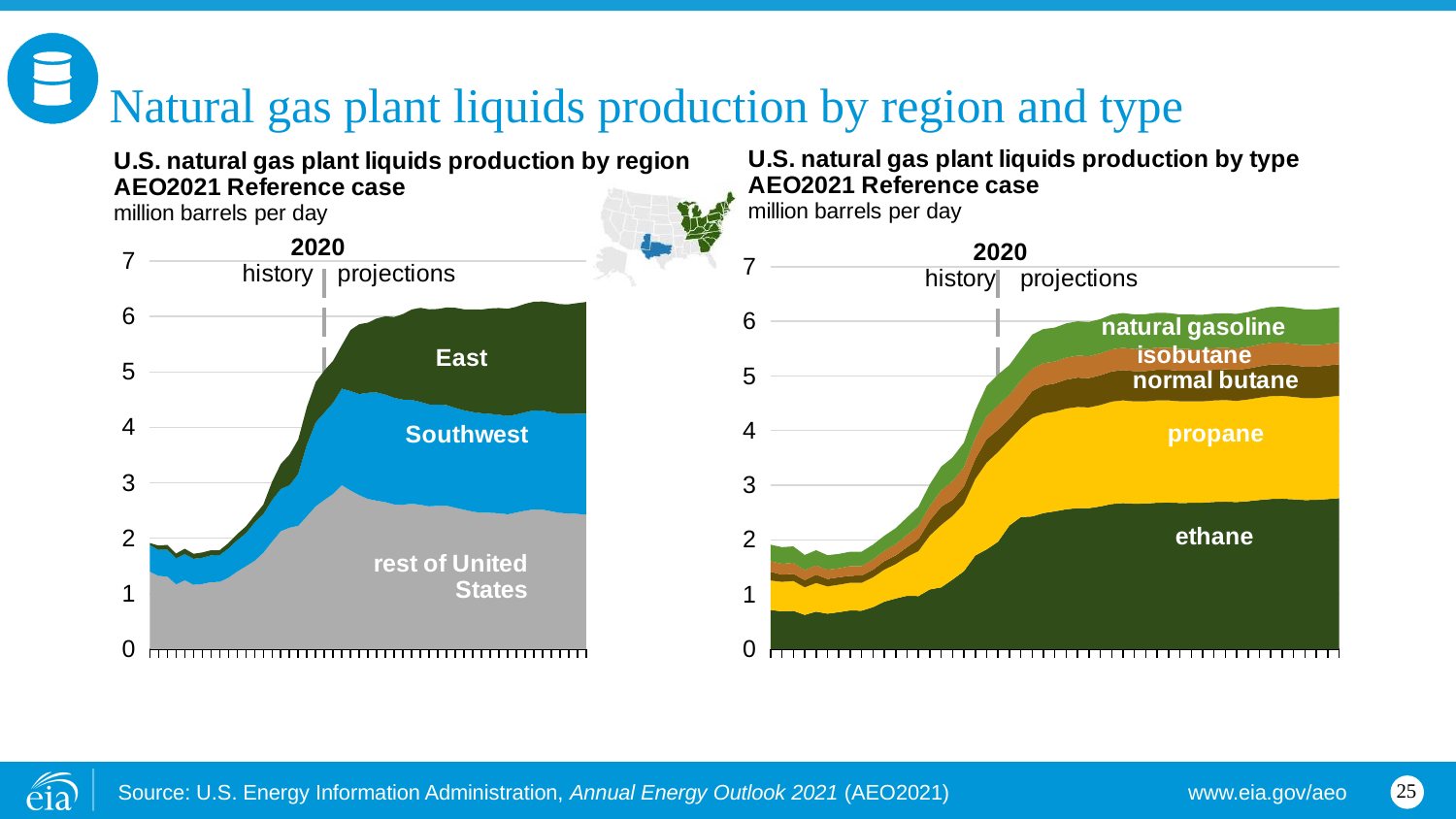
In the left chart (production by region), how many regions are stacked? 3 In the left chart (production by region), which year marks the boundary between history and projections? 2020 In the right chart (production by type), is the total production at the end of the projection period greater or less than 6 million barrels per day? greater In the left chart (production by region), is the total production at the start of the history period greater or less than 3 million barrels per day? less In the right chart (production by type), does total natural gas plant liquids production rise or fall from the start of the history period to the end of the projections? rise In the right chart (production by type), is the top of the ethane layer at the end of the projection period greater or less than 2 million barrels per day? greater In the right chart (production by type), which type is the bottom layer of the stack? ethane In the right chart (production by type), how many liquid types are stacked? 5 What kind of chart is the left chart, 'U.S. natural gas plant liquids production by region'? stacked area chart What kind of chart is the right chart, 'U.S. natural gas plant liquids production by type'? stacked area chart In the left chart (production by region), which region is the bottom layer of the stack? rest of United States